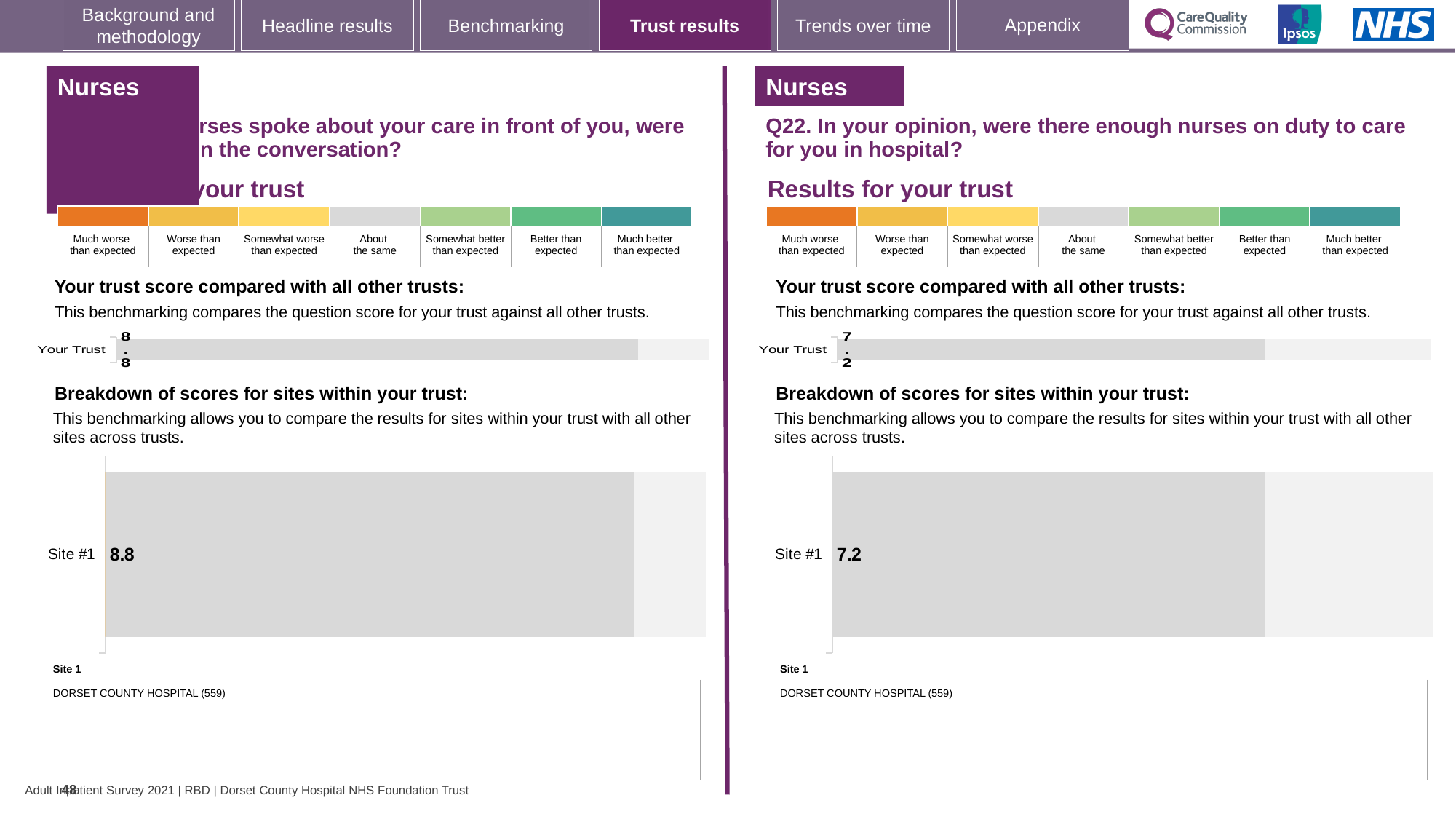
On the right-hand side of the slide (Q22), is the Site #1 score the same as the Your Trust score? Yes, both are 7.2 On the right-hand side of the slide (Q22), what is the score shown for Your Trust? 7.2 How many sites are shown in the 'Breakdown of scores for sites within your trust' chart on the right-hand side of the slide (Q22)? 1 Which hospital is listed as Site 1 on the right-hand side of the slide (Q22)? DORSET COUNTY HOSPITAL (559) What type of chart is used to show the Site #1 score on the right-hand side of the slide (Q22)? Bar chart Which is larger: the Site #1 score on the left-hand side of the slide or the Site #1 score on the right-hand side (Q22)? Left-hand side (8.8) What is the difference between the Your Trust score on the left-hand side of the slide and the Your Trust score on the right-hand side (Q22)? 1.6 What is the difference between the Site #1 score on the left-hand side of the slide and the Site #1 score on the right-hand side (Q22)? 1.6 On the left-hand side of the slide, what is the score shown for Site #1? 8.8 On the left-hand side of the slide, what is the score shown for Your Trust? 8.8 How many sites are shown in the 'Breakdown of scores for sites within your trust' chart on the left-hand side of the slide? 1 On the right-hand side of the slide (Q22), what is the score shown for Site #1? 7.2